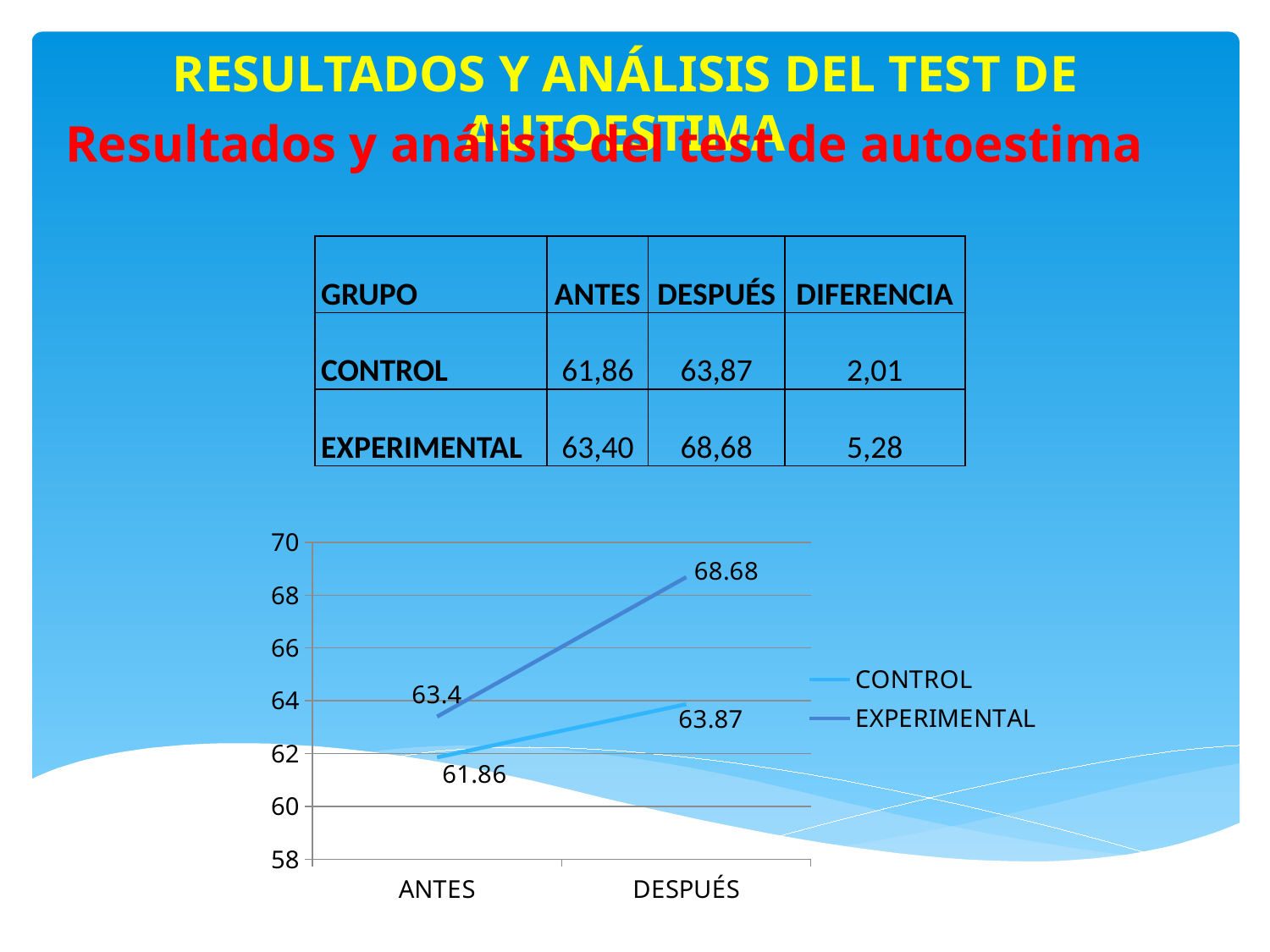
What is the difference between the EXPERIMENTAL and CONTROL values at DESPUÉS in the chart? 4.81 How many series does the chart legend list? 2 Which series has the higher value at DESPUÉS in the chart? EXPERIMENTAL What kind of chart is shown on the slide? line chart What is the value of the EXPERIMENTAL series at ANTES in the chart? 63.4 What is the value of the CONTROL series at ANTES in the chart? 61.86 What is the value of the CONTROL series at DESPUÉS in the chart? 63.87 How many categories are shown on the x axis of the chart? 2 Does the EXPERIMENTAL series rise or fall from ANTES to DESPUÉS? rise Which series and category has the lowest value in the chart? CONTROL at ANTES What is the value of the EXPERIMENTAL series at DESPUÉS in the chart? 68.68 What are the two entries listed in the chart legend? CONTROL and EXPERIMENTAL